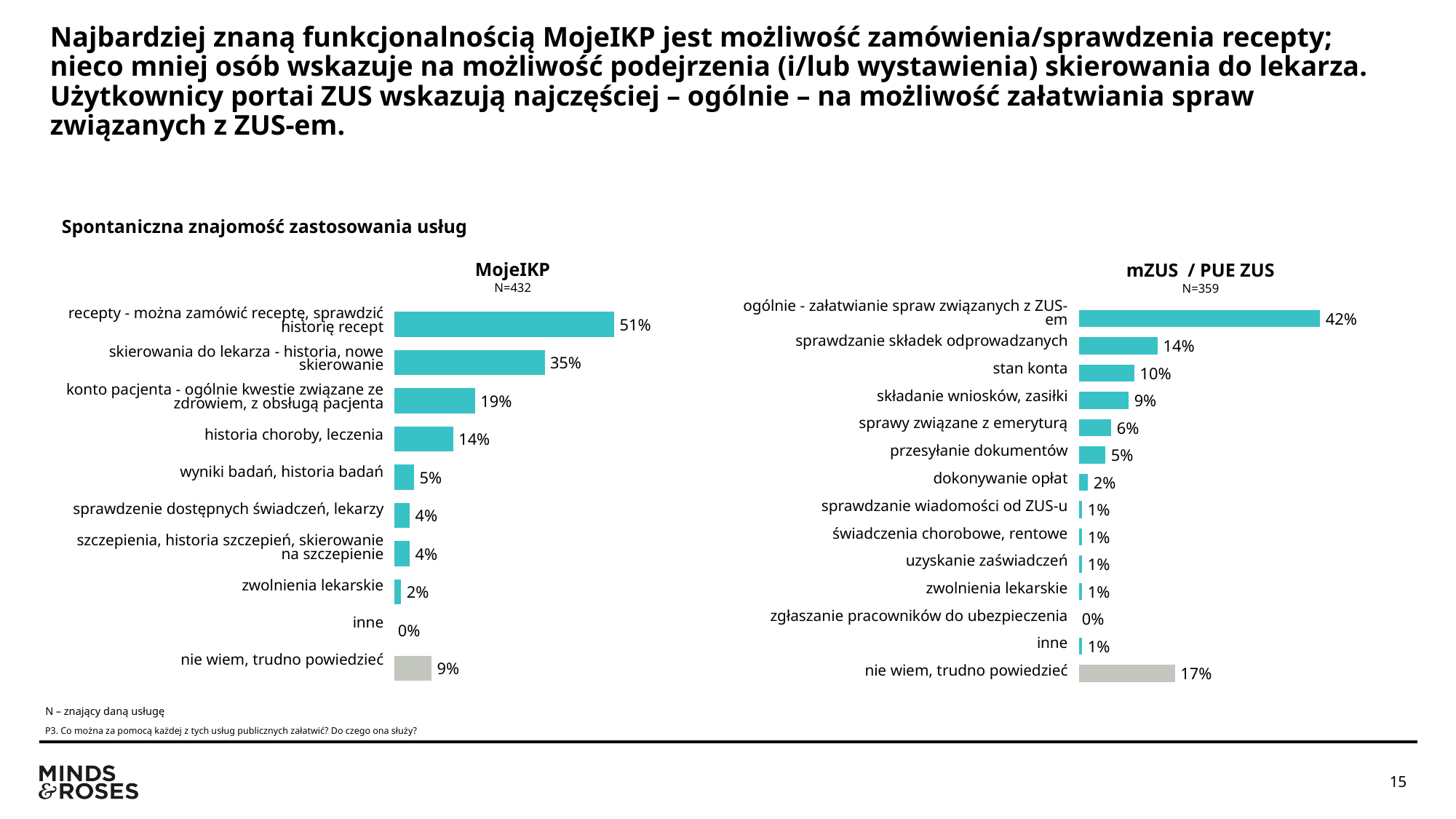
Which is larger: "nie wiem, trudno powiedzieć" in the MojeIKP chart or "nie wiem, trudno powiedzieć" in the mZUS / PUE ZUS chart? mZUS / PUE ZUS In the mZUS / PUE ZUS chart, what is the difference between "sprawdzanie składek odprowadzanych" and "stan konta"? 4 percentage points In the MojeIKP chart, what is the difference between "recepty - można zamówić receptę, sprawdzić historię recept" and "skierowania do lekarza - historia, nowe skierowanie"? 16 percentage points What type of chart is the MojeIKP chart? bar chart How many categories are shown in the MojeIKP chart? 10 In the MojeIKP chart, which category has the highest value? recepty - można zamówić receptę, sprawdzić historię recept In the mZUS / PUE ZUS chart, what is the value for "sprawy związane z emeryturą"? 6% In the MojeIKP chart, what is the value for "historia choroby, leczenia"? 14% How many categories are shown in the mZUS / PUE ZUS chart? 14 In the mZUS / PUE ZUS chart, which category has the highest value? ogólnie - załatwianie spraw związanych z ZUS-em In the MojeIKP chart, which category has the lowest value? inne What is the sample size (N) shown for the mZUS / PUE ZUS chart? N=359